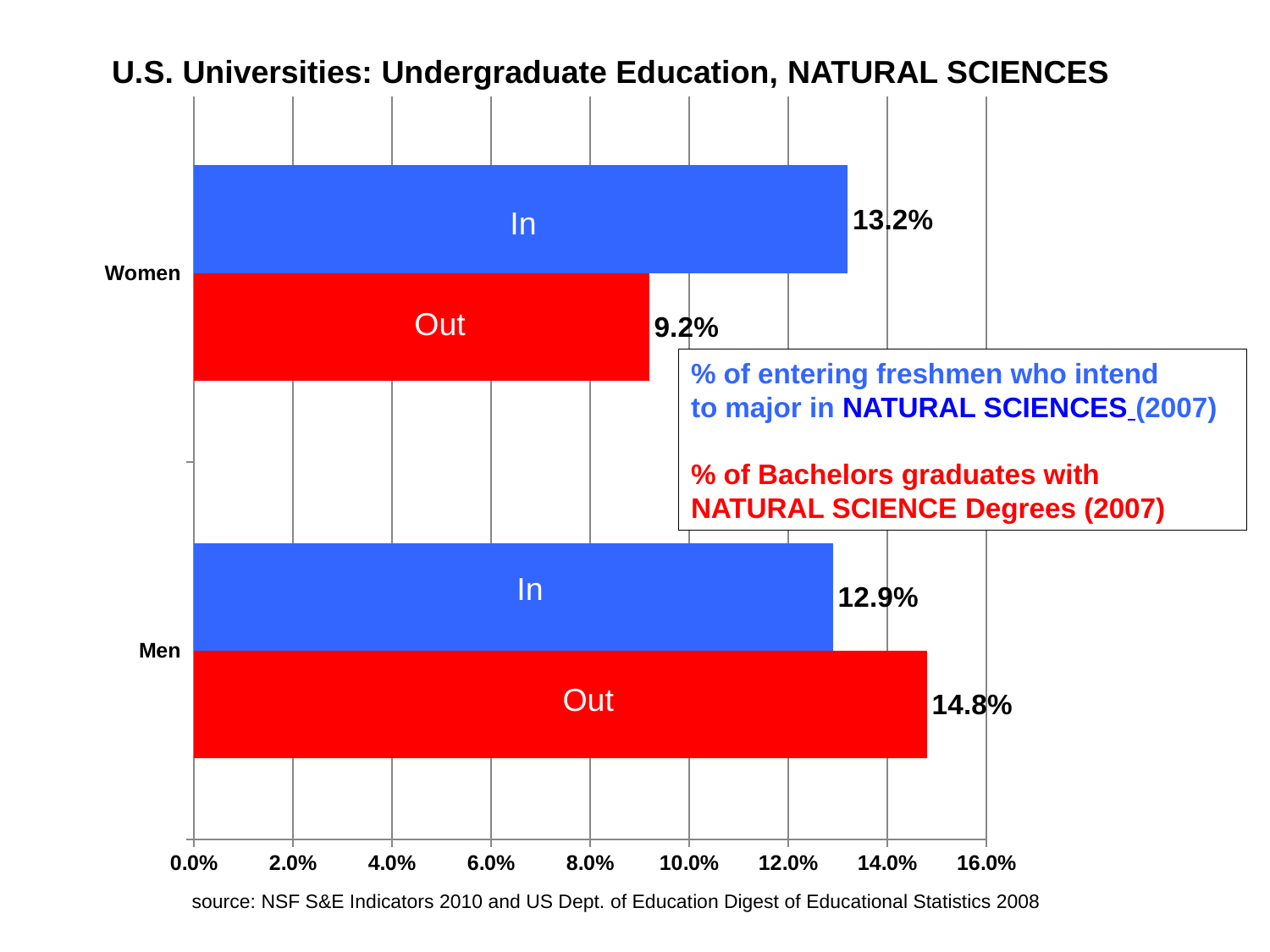
What colour are the "Out" bars? Red Which is larger for Men, the "In" value or the "Out" value? Out What is the difference between the "In" and "Out" values for Women? 4.0% What is the "Out" value for Men? 14.8% What is the difference between the "Out" and "In" values for Men? 1.9% What kind of chart is shown on the slide? Bar chart What is the "Out" value for Women? 9.2% Which bar has the highest value on the chart? Men, Out What is the "In" value for Men? 12.9% How many groups (categories) are shown on the vertical axis? 2 What is the "In" value for Women? 13.2% Which bar has the lowest value on the chart? Women, Out